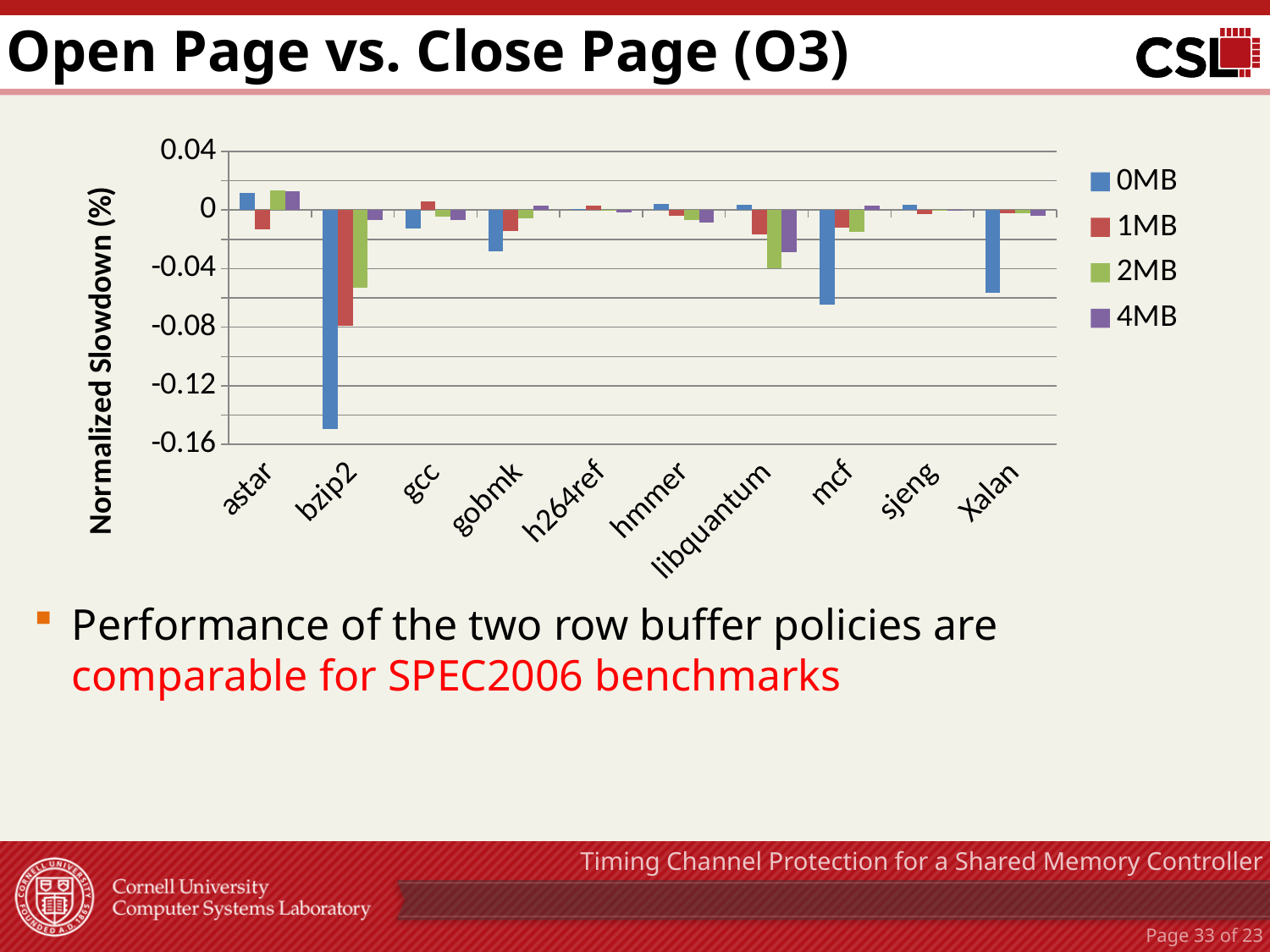
Is the 0MB value for mcf greater or less than -0.04? less Is the 0MB value for bzip2 greater or less than -0.12? less Which benchmark has the lowest 0MB value in the chart? bzip2 Which series are listed in the chart's legend? 0MB, 1MB, 2MB, 4MB Is the 0MB value for gobmk greater or less than -0.04? greater How many series does the chart's legend list? 4 How many benchmark categories are shown on the x axis of the chart? 10 Which is lower, the 0MB value for gcc or the 0MB value for gobmk? gobmk What kind of chart is shown on the slide? bar chart What is the label of the chart's y axis? Normalized Slowdown (%) Which is lower, the 0MB value for bzip2 or the 0MB value for mcf? bzip2